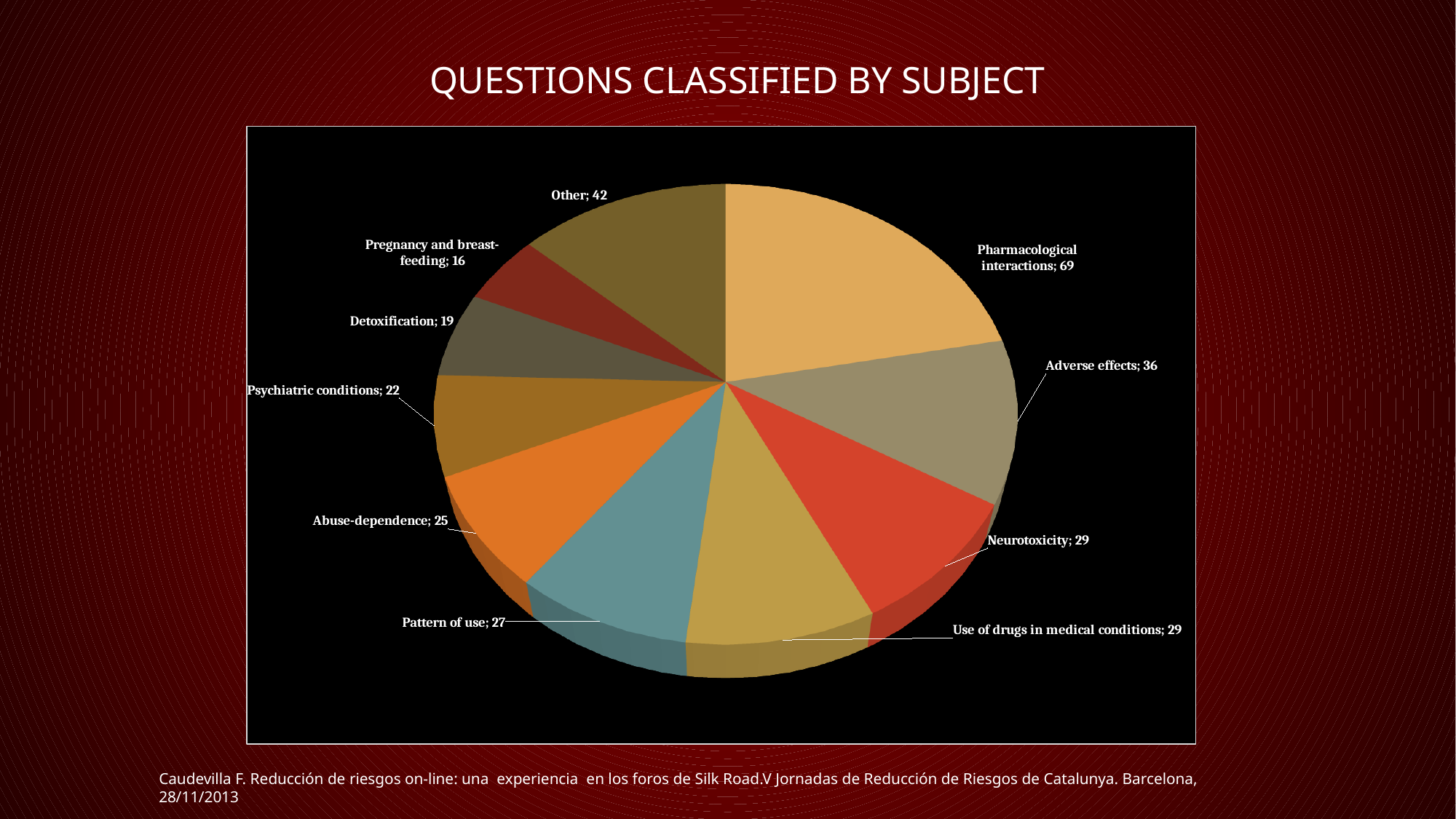
Which category has the highest value? Pharmacological interactions How many categories does the pie chart show? 10 What is the value for Pharmacological interactions? 69 What is the value for Detoxification? 19 What is the title of the slide? QUESTIONS CLASSIFIED BY SUBJECT Which category has the lowest value? Pregnancy and breast-feeding What is the value for Adverse effects? 36 What is the difference between the values for Pharmacological interactions and Adverse effects? 33 What kind of chart is shown on the slide? pie chart Which is larger, the value for Other or the value for Adverse effects? Other What is the value for Pattern of use? 27 What is the total of all the values shown in the pie chart? 314